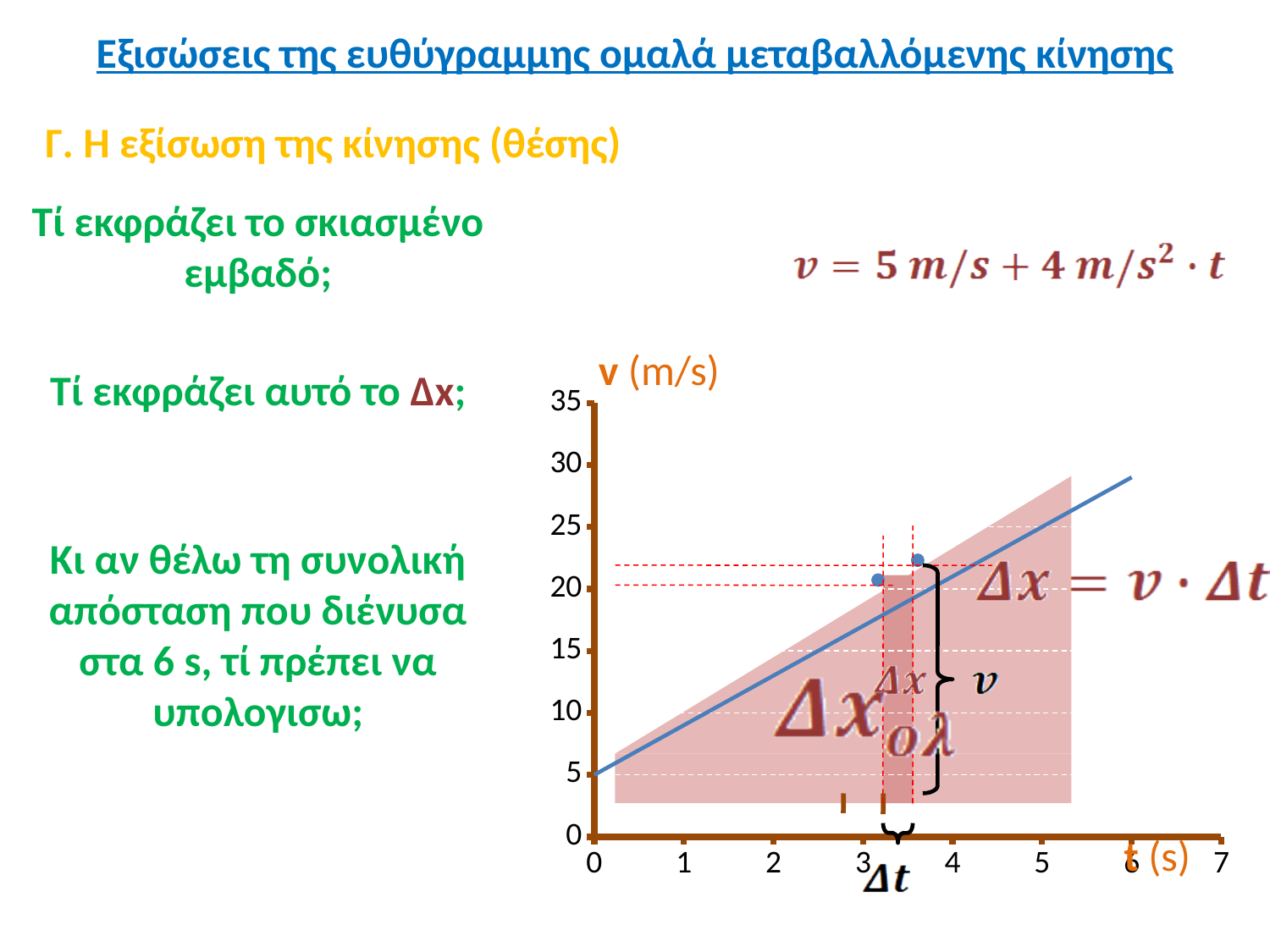
Which is larger, the value of v at t = 5 or at t = 2? t = 5 What kind of chart is shown on the slide? line chart Is the value of v at t = 1 greater or less than 5? greater What label is given to the vertical axis of the chart? v (m/s) Is the value of v at t = 2 greater or less than 15? less Is the value of v at t = 5 greater or less than 20? greater Does the velocity v rise or fall as t increases along the x axis? rises What is the highest tick value shown on the vertical axis? 35 What is the value of v at t = 0 on the chart? 5